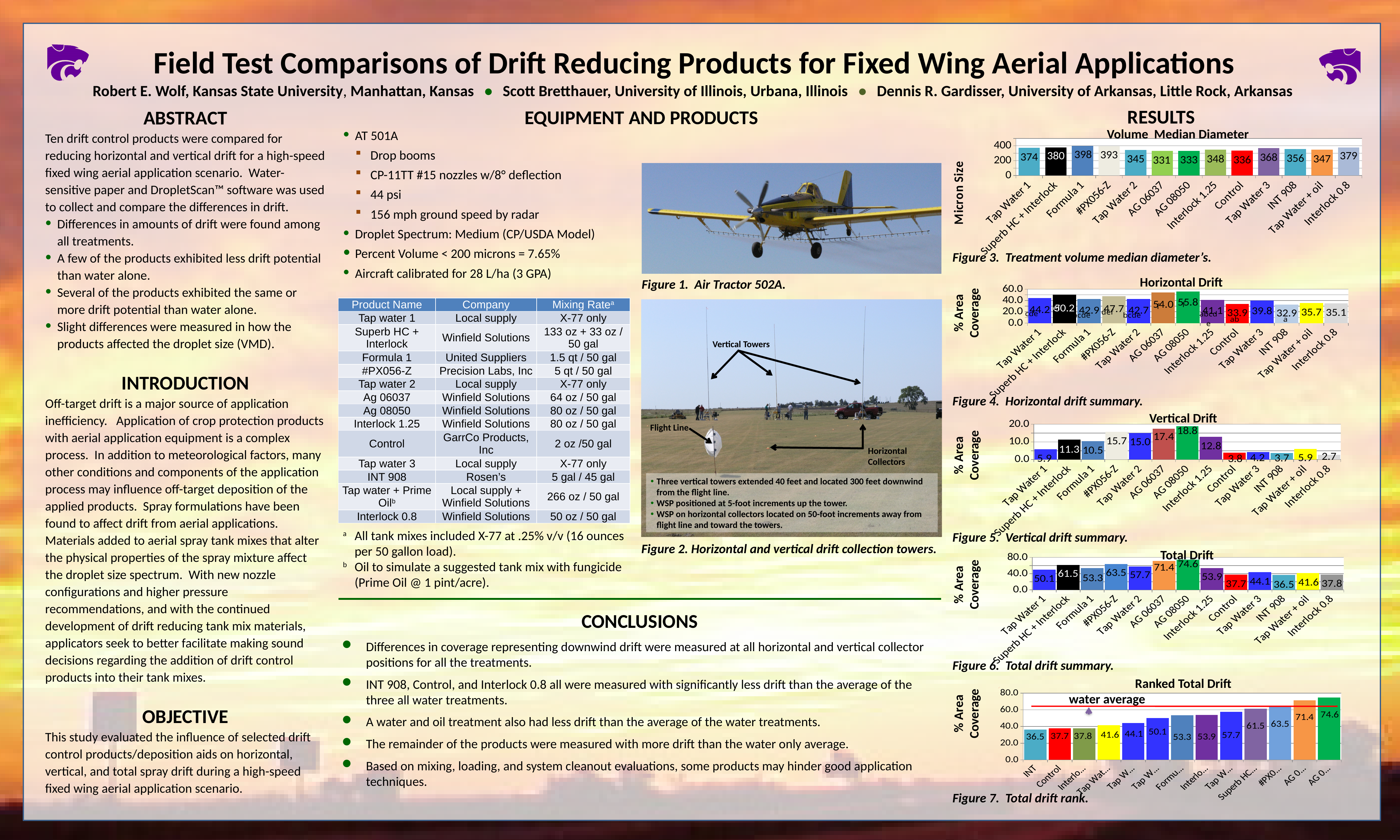
What kind of chart is the Ranked Total Drift chart? bar chart In the Ranked Total Drift chart, do the values rise or fall from left to right? rise In the Total Drift chart, is the value for Control greater or less than 40.0? less In the Vertical Drift chart, which treatment has the highest % area coverage? AG 08050 In the Volume Median Diameter chart, which treatment has the lowest micron size? AG 06037 In the Vertical Drift chart, what is the value for Interlock 0.8? 2.7 How many treatments are plotted in the Horizontal Drift chart? 13 In the Horizontal Drift chart, what is the % area coverage for AG 08050? 55.8 In the Total Drift chart, which is larger, Superb HC + Interlock or #PX056-Z? #PX056-Z In the Volume Median Diameter chart, what is the value for Formula 1? 398 In the Total Drift chart, what is the difference between AG 08050 and INT 908? 38.1 In the Horizontal Drift chart, which treatment has the lowest % area coverage? INT 908